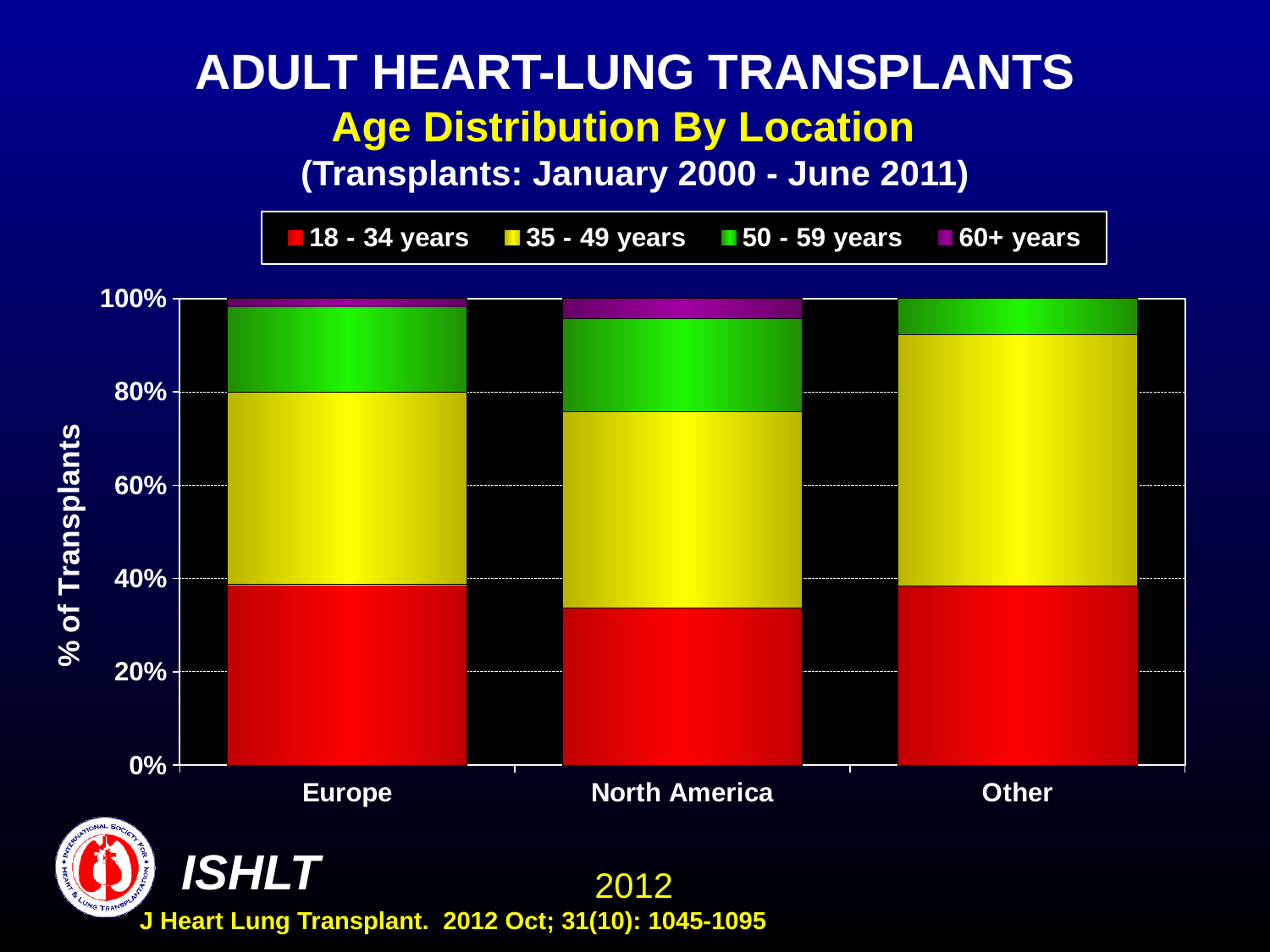
What is the label on the y axis? % of Transplants Is the 18 - 34 years share for North America greater or less than 40%? less Is the 18 - 34 years share for Europe greater or less than 20%? greater Which location has the smallest share of transplants in the 18 - 34 years group? North America How many age groups does the legend list? 4 Which location has the smallest share of transplants in the 50 - 59 years group? Other How many locations are shown on the x axis? 3 What kind of chart is shown on the slide? stacked bar chart Which location has the largest share of transplants in the 35 - 49 years group? Other Which has the larger 18 - 34 years share, Europe or North America? Europe What is the total height of the Europe stacked bar? 100% Which location has the largest share of transplants in the 60+ years group? North America